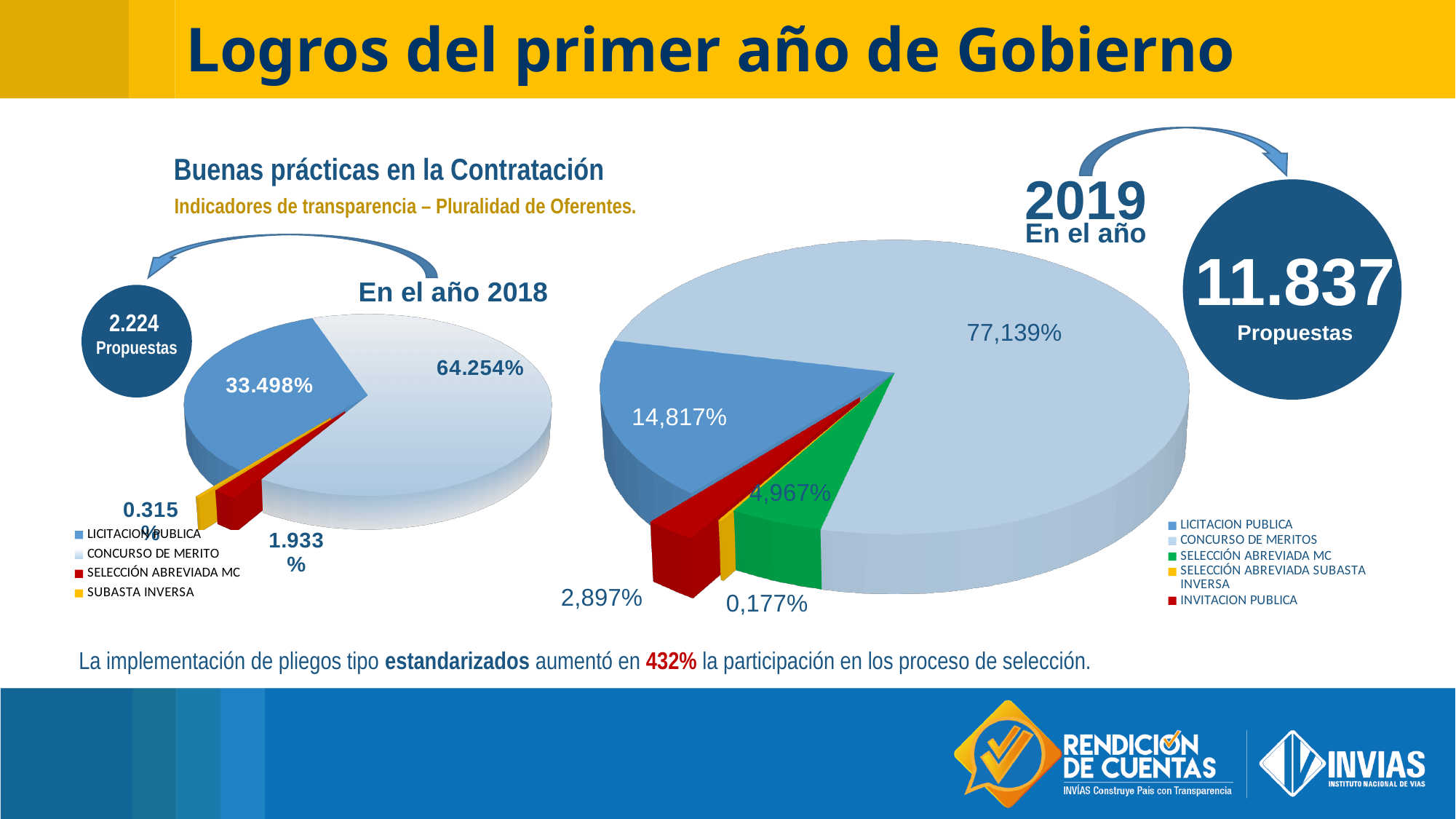
In the 'En el año 2019' pie chart, what is the value for CONCURSO DE MERITOS? 77,139% In the 'En el año 2019' pie chart, which category has the smallest share? SELECCIÓN ABREVIADA SUBASTA INVERSA In the 'En el año 2018' pie chart, which category has the largest share? CONCURSO DE MERITO What type of chart is used for 'En el año 2019'? Pie chart In the 'En el año 2018' pie chart, what is the value for SUBASTA INVERSA? 0.315% In the 'En el año 2018' pie chart, how many categories does the legend list? 4 In the 'En el año 2019' pie chart, how many categories does the legend list? 5 In the 'En el año 2018' pie chart, what is the value for CONCURSO DE MERITO? 64.254% In the 'En el año 2018' pie chart, which category has the smallest share? SUBASTA INVERSA In the 'En el año 2019' pie chart, what is the value for LICITACION PUBLICA? 14,817% In the 'En el año 2019' pie chart, what is the value for INVITACION PUBLICA? 2,897% In the 'En el año 2018' pie chart, what is the value for LICITACION PUBLICA? 33.498%